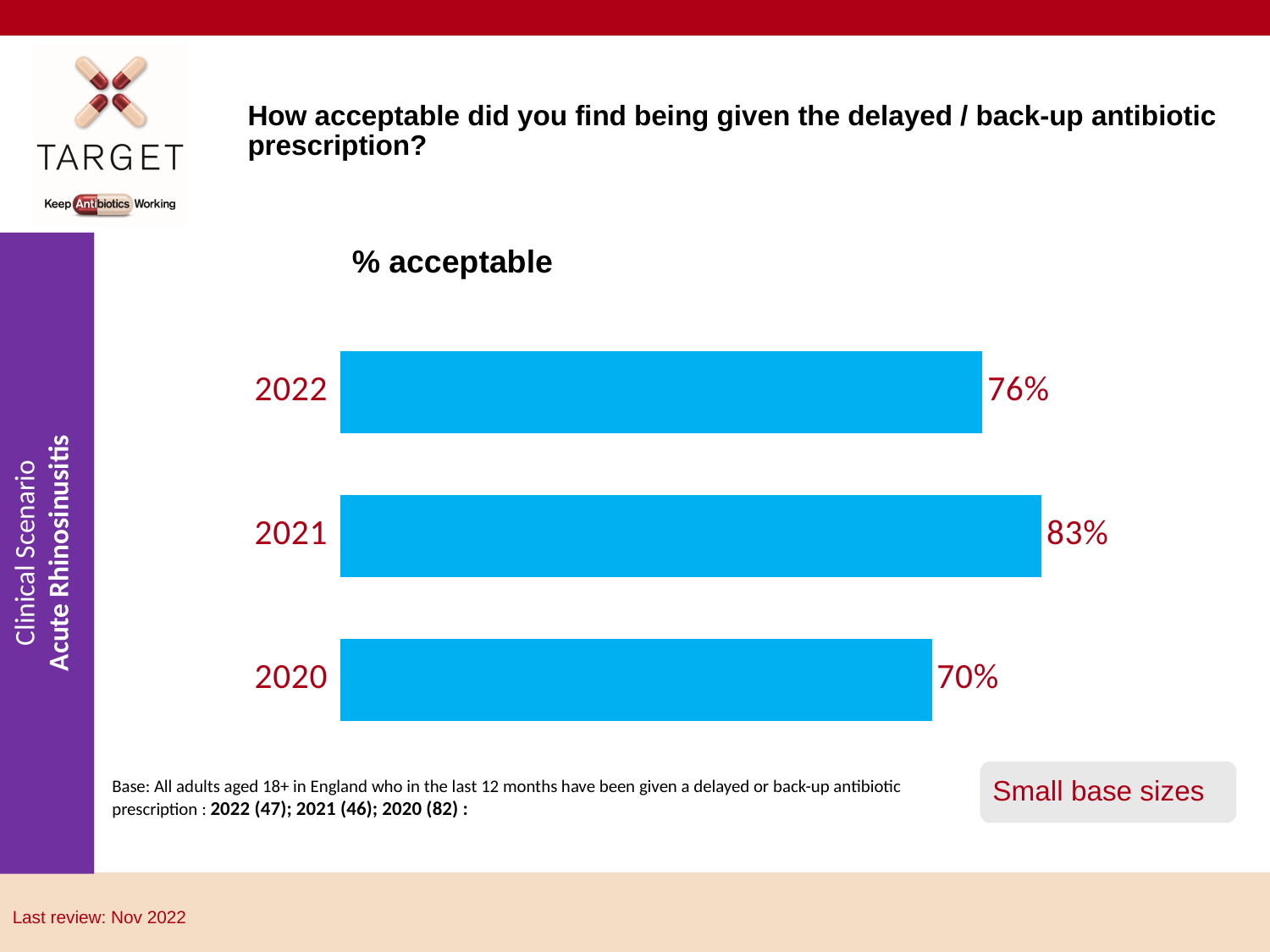
What type of chart is shown on the slide? Bar chart What is the % acceptable value for 2021? 83% What is the % acceptable value for 2022? 76% What colour are the bars in the chart? Blue What is the difference in % acceptable between 2021 and 2020? 13 percentage points Which year has the lowest % acceptable? 2020 Which year has a larger % acceptable, 2022 or 2020? 2022 How many years are shown in the chart? 3 Which year has the highest % acceptable? 2021 What is the difference in % acceptable between 2021 and 2022? 7 percentage points What is the title of the chart? % acceptable What is the % acceptable value for 2020? 70%